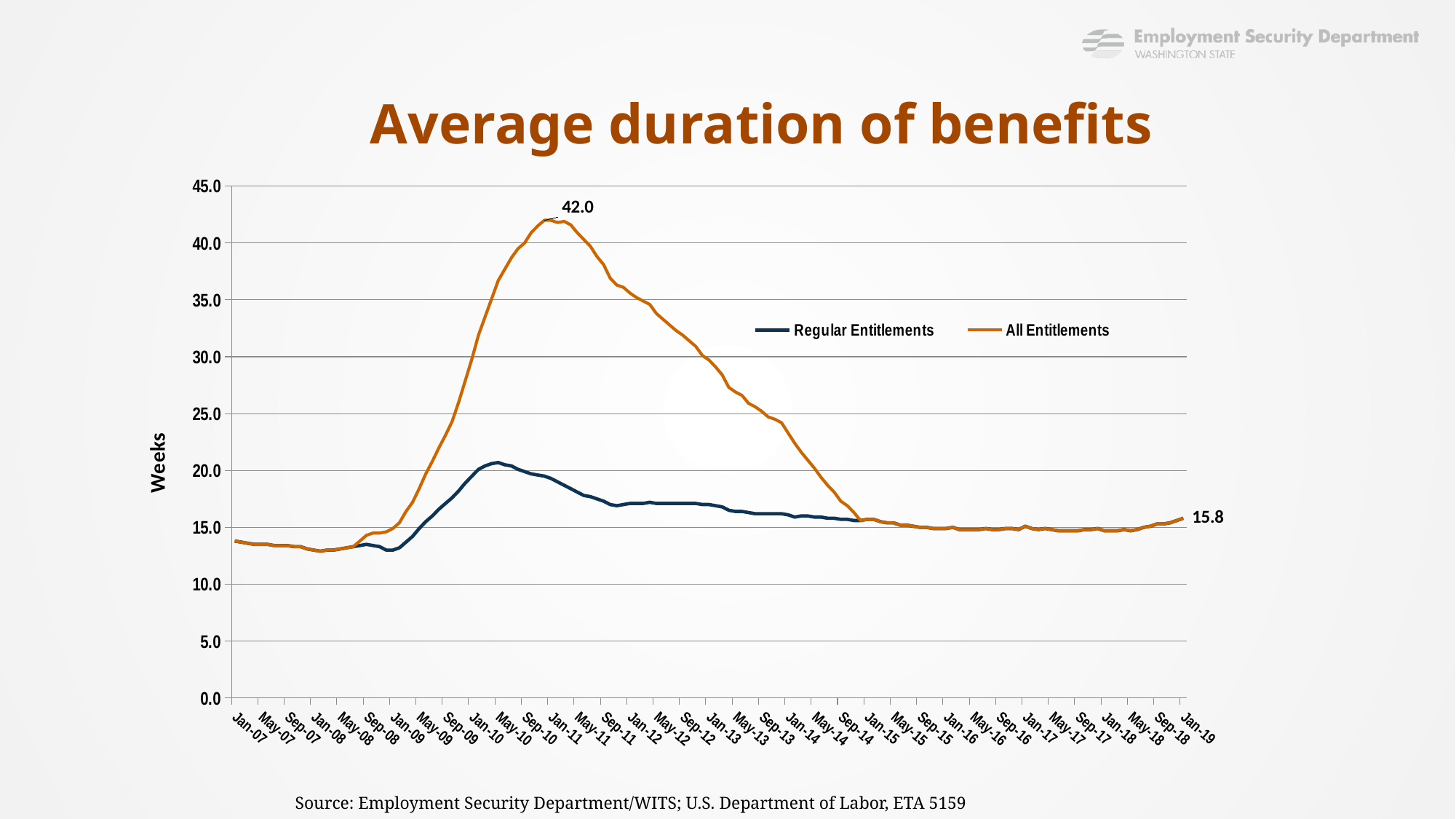
What kind of chart is shown on the slide? line chart What is the peak value labelled on the All Entitlements line? 42.0 What value is labelled at the end of the chart at Jan-19? 15.8 Which series reaches the highest value on the chart? All Entitlements At Jan-11, which series has the higher value, Regular Entitlements or All Entitlements? All Entitlements What is the label on the vertical axis? Weeks Is the value for Regular Entitlements at May-10 greater or less than 25.0? less Is the value for Regular Entitlements at Sep-12 greater or less than 15.0? greater How many series does the legend list? 2 Is the value for All Entitlements at Jan-11 greater or less than 40.0? greater Do the values for All Entitlements rise or fall between Jan-11 and Jan-15? fall What is the difference between the labelled peak of 42.0 and the labelled Jan-19 value of 15.8? 26.2